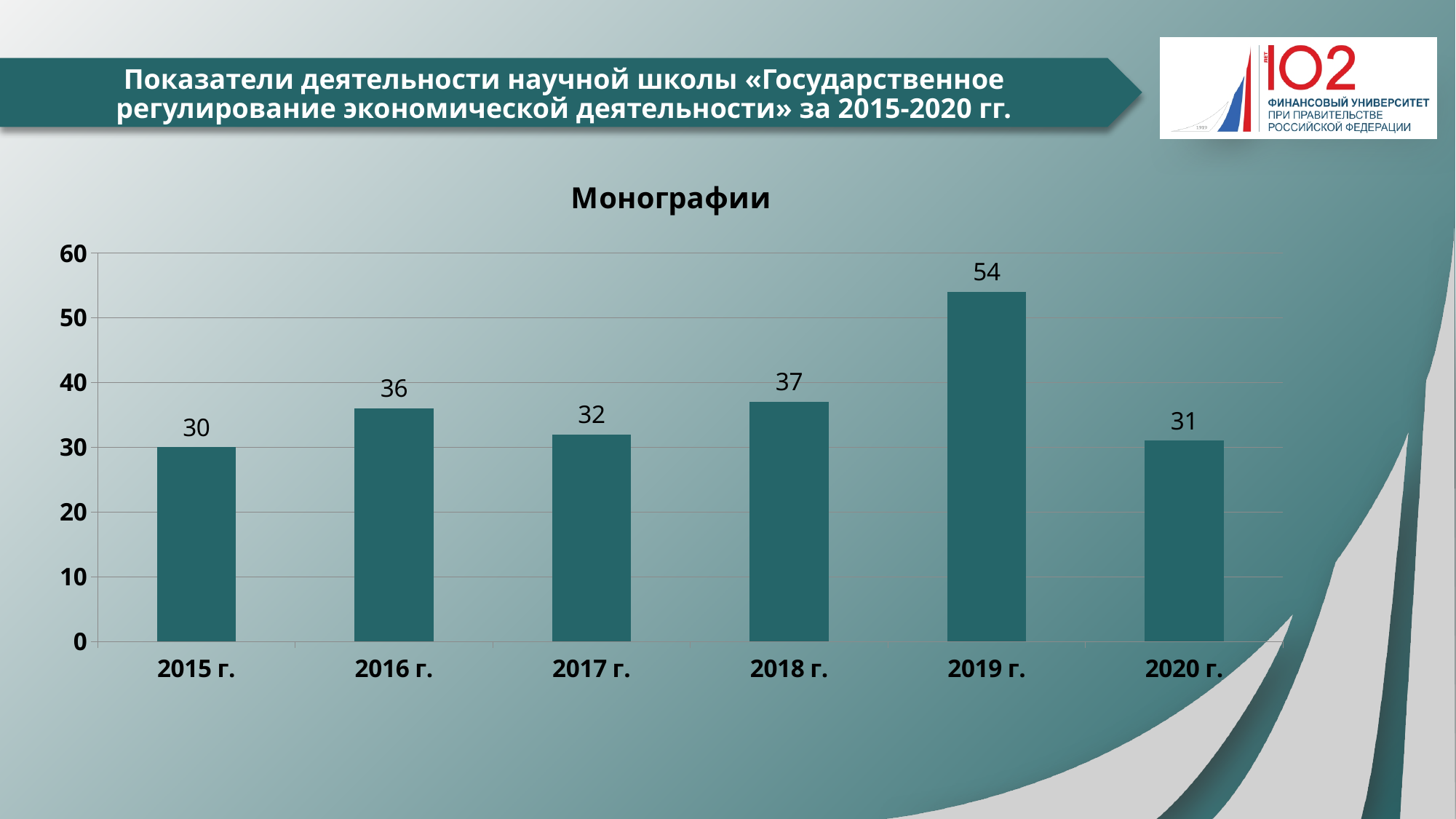
What is the title of the chart? Монографии Which year has the lowest value in the Монографии chart? 2015 г. What is the value for 2015 г. in the Монографии chart? 30 What is the difference between the values for 2016 г. and 2015 г.? 6 Which is larger, the value for 2016 г. or the value for 2020 г.? 2016 г. What is the value for 2019 г. in the Монографии chart? 54 How many years are shown on the x axis of the chart? 6 Is the value for 2019 г. greater or less than 50? greater Which year has the highest value in the Монографии chart? 2019 г. What is the value for 2017 г. in the Монографии chart? 32 What is the difference between the values for 2019 г. and 2018 г.? 17 What kind of chart is shown on the slide? bar chart